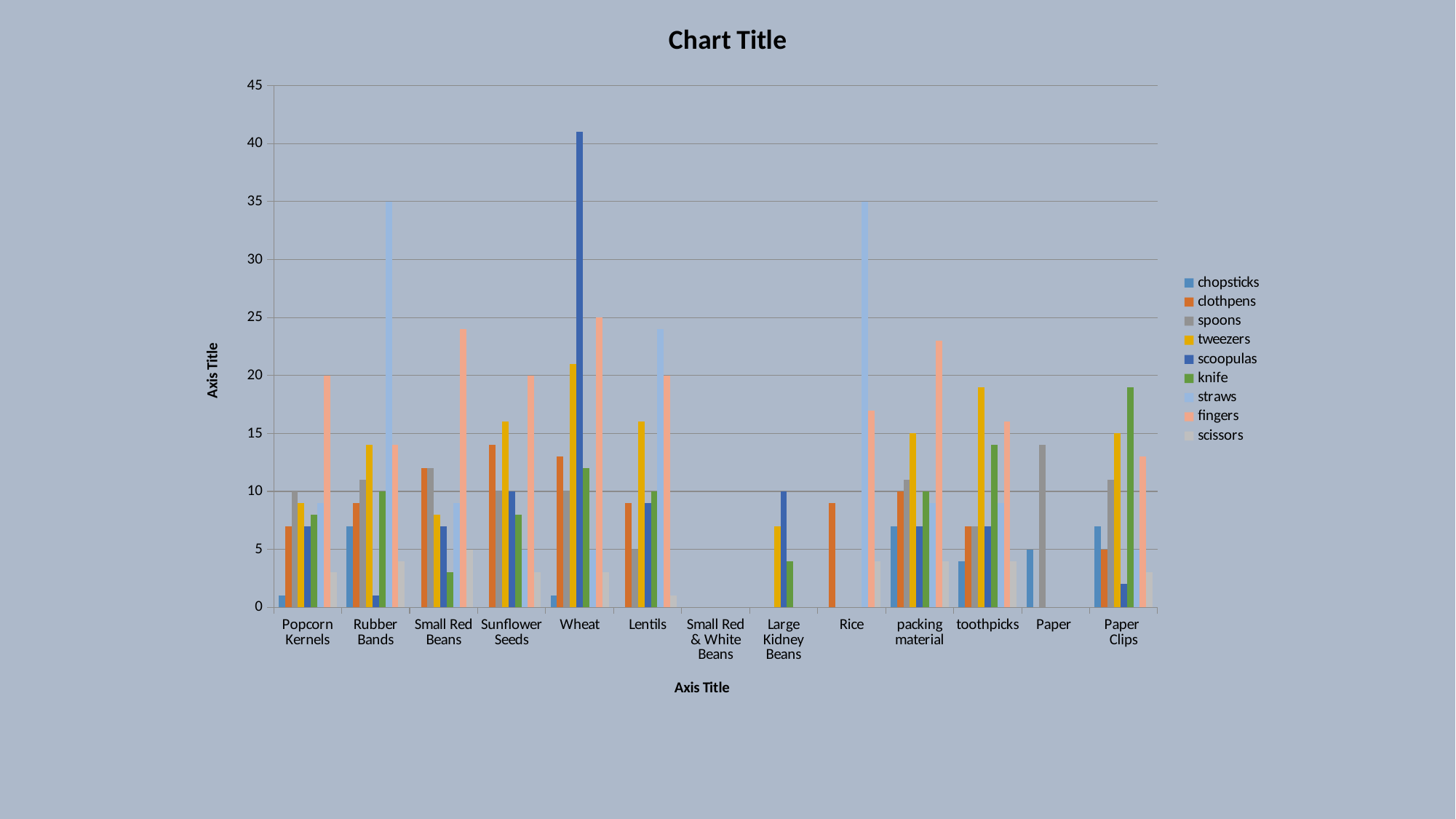
Which series has the tallest bar for Wheat? scoopulas Is the value for scoopulas at Wheat greater or less than 40? greater Is the value for clothpens at Rice greater or less than 10? less Which category contains the tallest bar in the chart? Wheat Which is larger: the value for tweezers at toothpicks or the value for tweezers at Lentils? toothpicks What is the title of the chart? Chart Title Is the value for straws at Rubber Bands greater or less than 30? greater How many series does the legend list? 9 What kind of chart is shown on the slide? bar chart What is the value for fingers at Wheat? 25 How many categories are shown along the x axis? 13